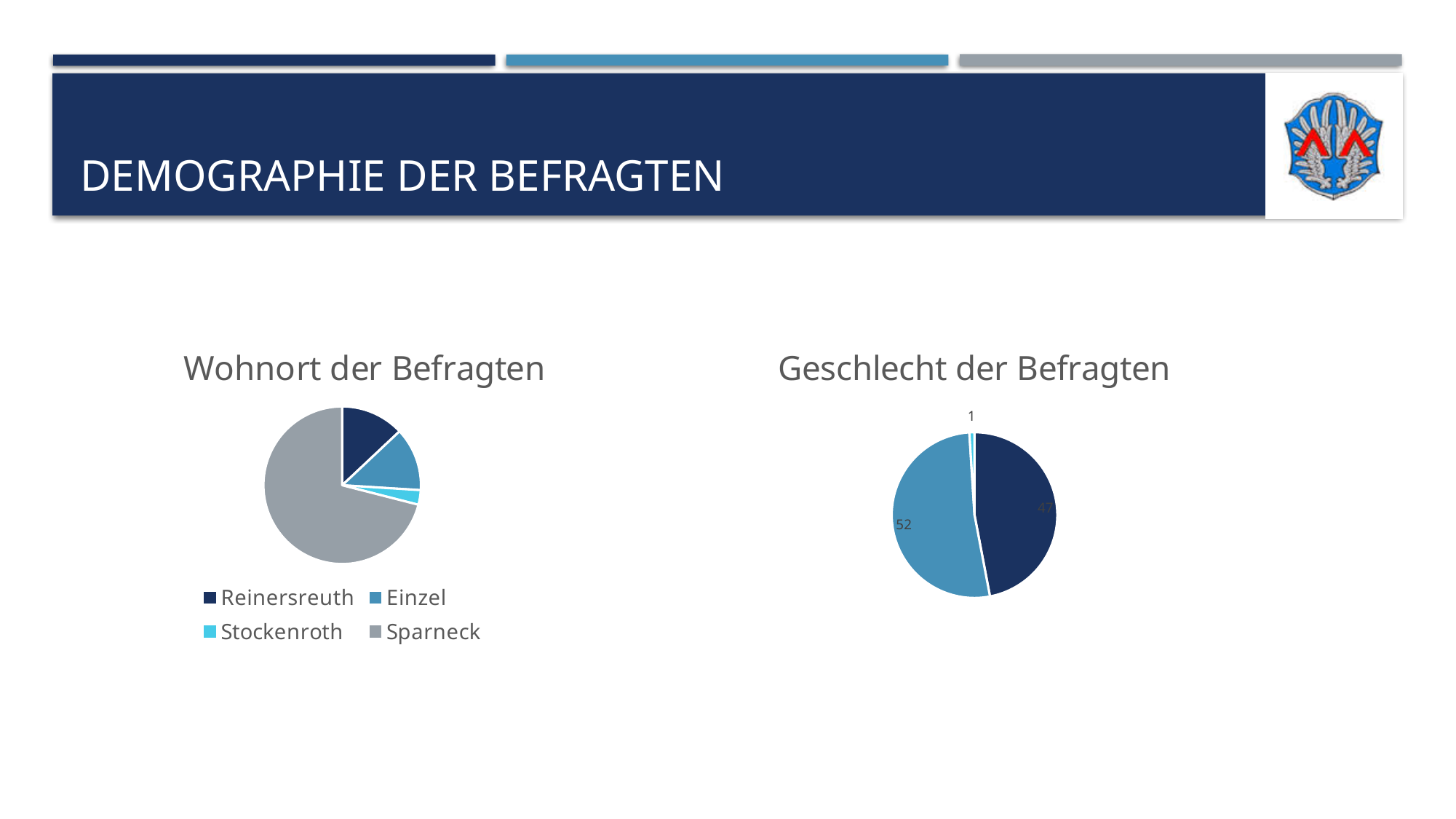
What kind of chart is "Geschlecht der Befragten"? pie chart In the "Wohnort der Befragten" chart, which category has the smallest slice? Stockenroth In the "Wohnort der Befragten" chart, which category has the largest slice? Sparneck What kind of chart is "Wohnort der Befragten"? pie chart In the "Geschlecht der Befragten" chart, what is the value of the smallest slice? 1 In the "Geschlecht der Befragten" chart, what is the value of the largest slice? 52 In the "Geschlecht der Befragten" chart, what is the total of all slice values? 100 In the "Wohnort der Befragten" chart, which slice is larger, Sparneck or Einzel? Sparneck How many slices does the "Geschlecht der Befragten" pie chart have? 3 In the "Geschlecht der Befragten" chart, what is the difference between the two largest slices? 5 In the "Wohnort der Befragten" chart, which category is shown in grey? Sparneck How many categories does the legend of the "Wohnort der Befragten" chart list? 4